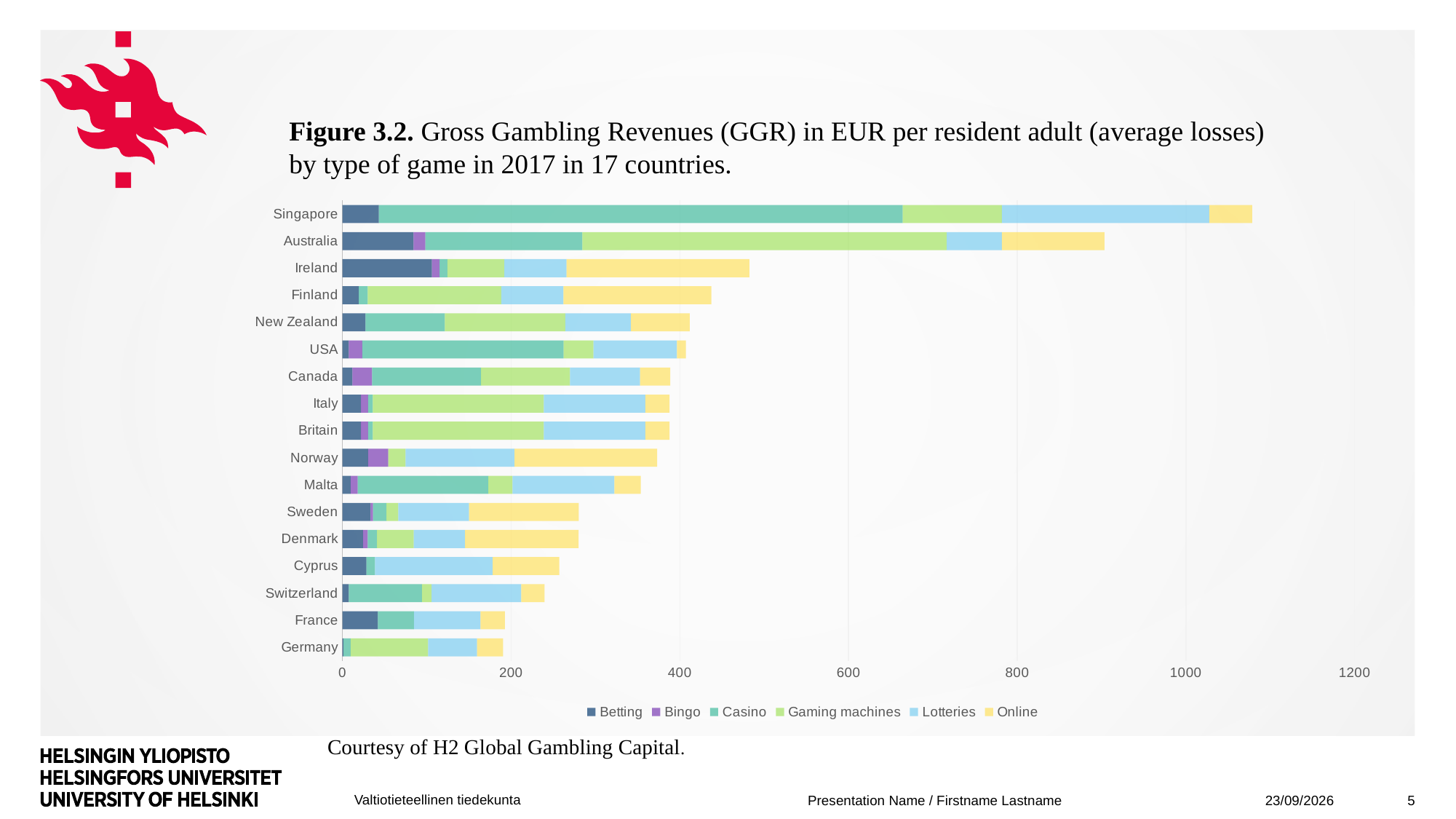
Is the total value for Australia greater or less than 800? greater Is the total value for Singapore greater or less than 1000? greater Is the total value for Cyprus greater or less than 200? greater Which series is shown in yellow in the legend? Online How many countries are listed on the chart? 17 Do the total bar lengths rise or fall going from Singapore at the top to Germany at the bottom? fall How many series does the legend list? 6 Which country has the highest total gross gambling revenue per resident adult? Singapore Which has the larger total bar, Singapore or Australia? Singapore What kind of chart is shown on the slide? Stacked bar chart